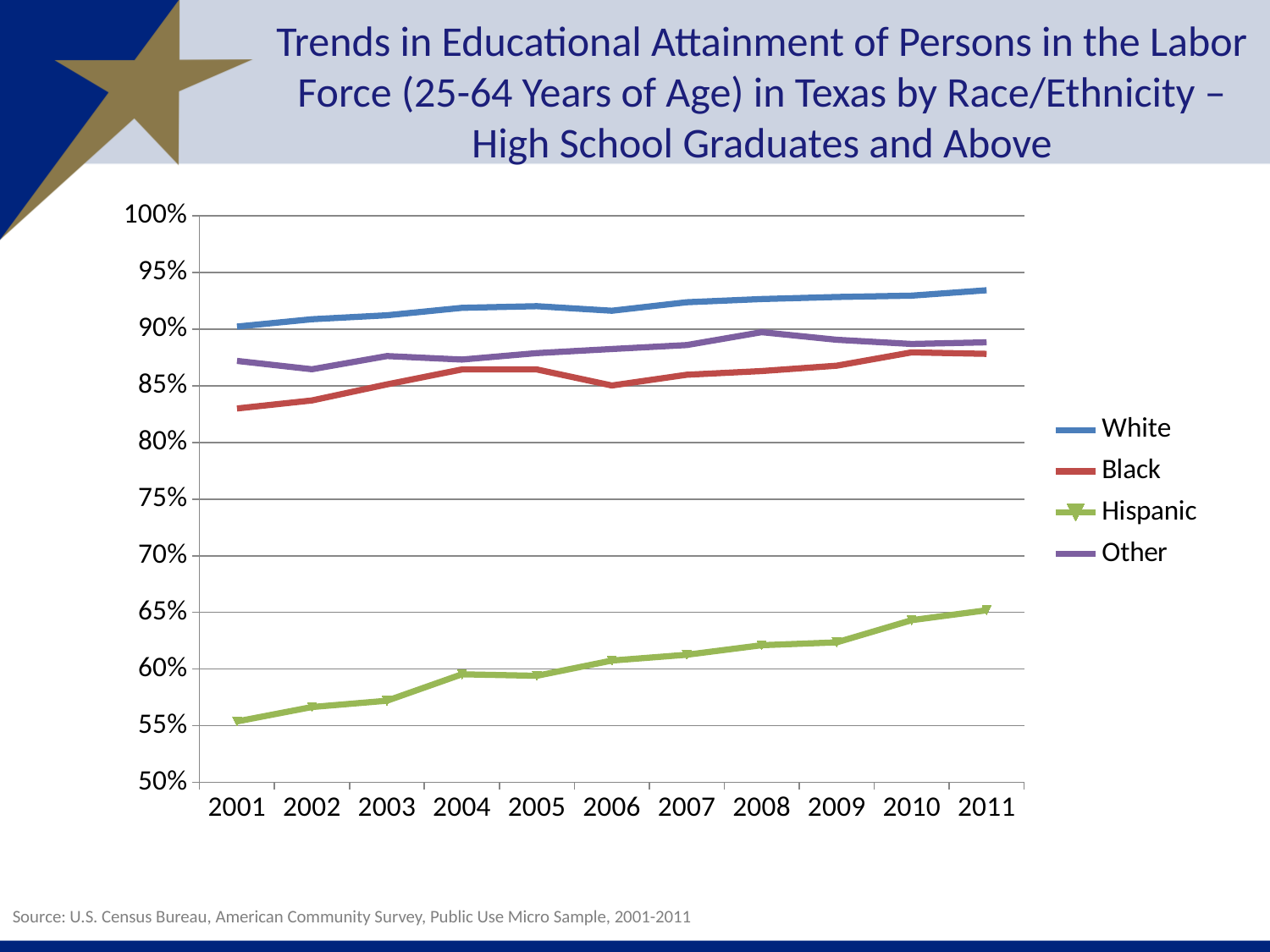
In 2008, which is higher: the value for Other or the value for Black? Other Is the value for Black in 2001 greater or less than 85%? less How many series does the legend list? 4 Which series has the lowest value in 2011? Hispanic Is the value for White in 2011 greater or less than 90%? greater Which series has the highest value in 2011? White Is the value for Hispanic in 2001 greater or less than 60%? less What are the four entries listed in the legend? White, Black, Hispanic, Other Does the Hispanic line rise or fall from 2001 to 2011? rises How many years are shown along the x axis? 11 What kind of chart is shown on the slide? line chart